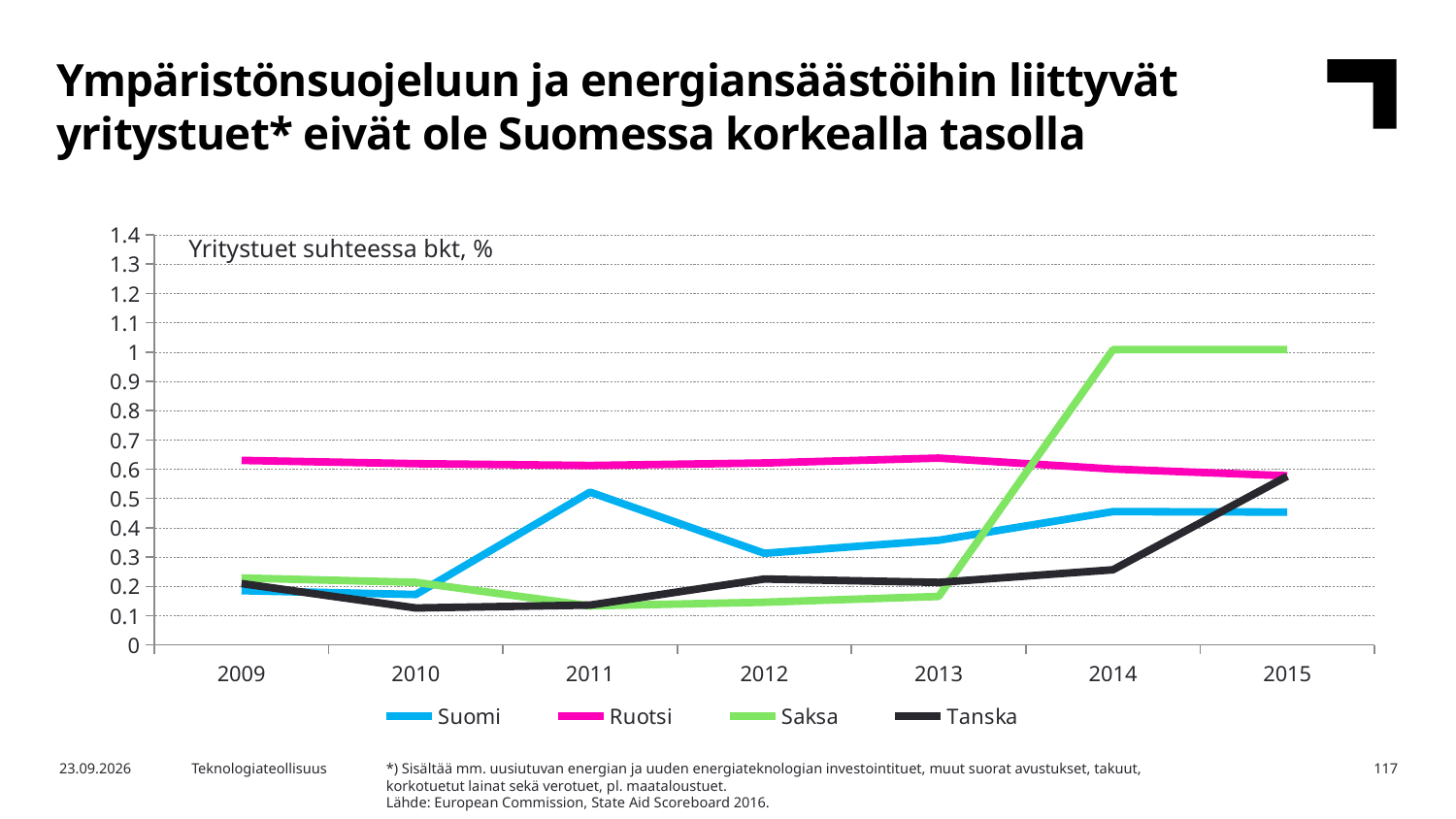
How many years are shown on the x axis? 7 What kind of chart is shown on the slide? line chart Which country has the lowest value in 2010? Tanska Which country has the highest value in 2009? Ruotsi Which country has the highest value in 2015? Saksa How many series does the legend list? 4 What colour is the line for Tanska? black What is the title shown inside the chart area? Yritystuet suhteessa bkt, % In 2011, which is larger, the value for Suomi or the value for Ruotsi? Ruotsi Is the value for Suomi in 2011 greater or less than 0.4? greater Is the value for Saksa in 2015 greater or less than 0.9? greater Does the value for Saksa rise or fall from 2013 to 2014? rise